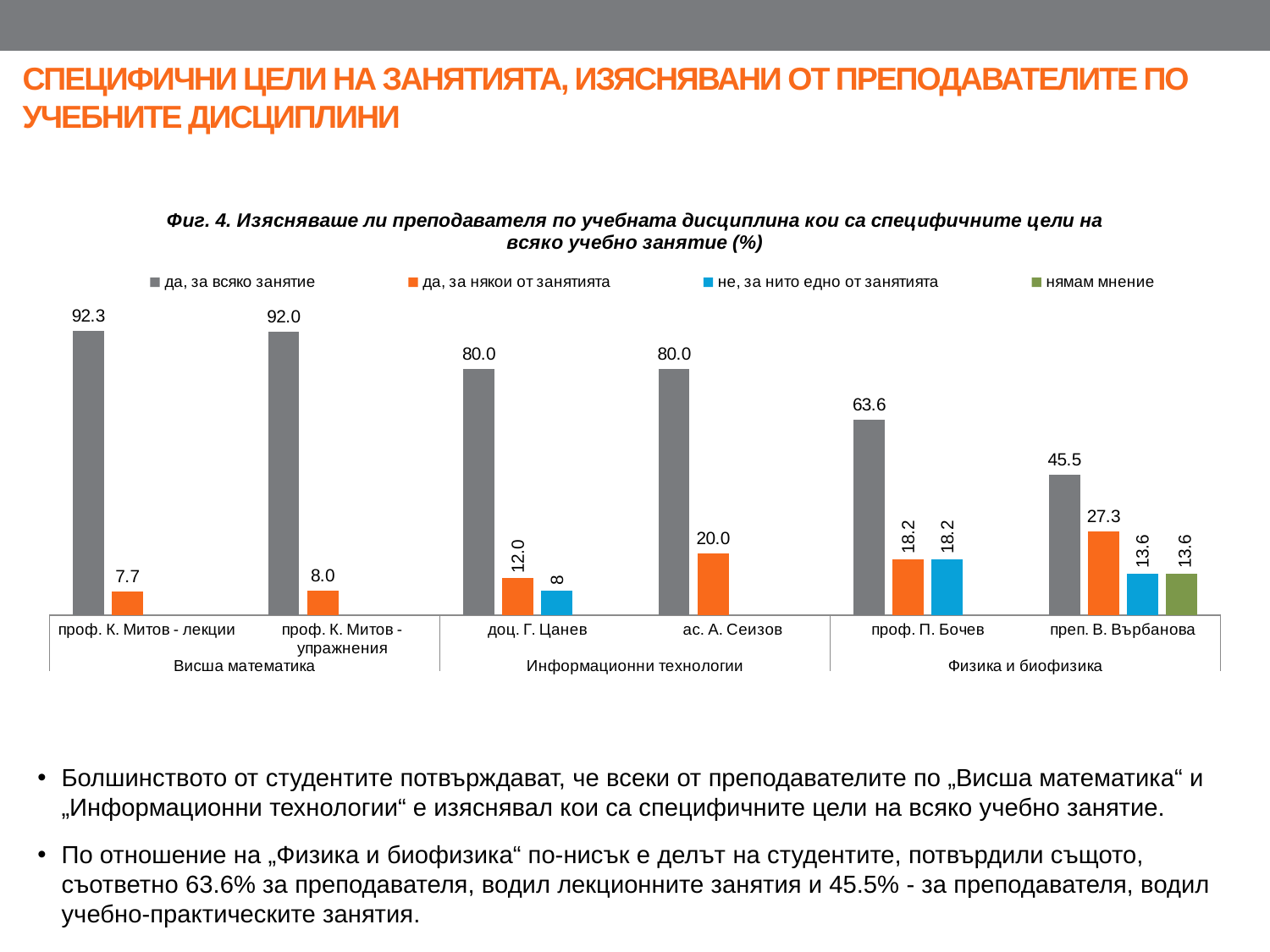
What is the value of "не, за нито едно от занятията" for доц. Г. Цанев? 8 What is the value of "да, за всяко занятие" for проф. К. Митов - лекции? 92.3 What is the value of "нямам мнение" for преп. В. Върбанова? 13.6 How many lecturers (categories) are shown on the x axis? 6 What is the value of "да, за някои от занятията" for ас. А. Сеизов? 20.0 Which lecturer has the lowest value for "да, за всяко занятие"? преп. В. Върбанова Which discipline group is listed first on the x axis? Висша математика Which lecturer has the highest value for "да, за някои от занятията"? преп. В. Върбанова How many series does the legend list? 4 Which is larger: the "да, за някои от занятията" value for проф. П. Бочев or for ас. А. Сеизов? ас. А. Сеизов What type of chart is shown on the slide? bar chart What is the difference between the "да, за всяко занятие" values for проф. П. Бочев and преп. В. Върбанова? 18.1